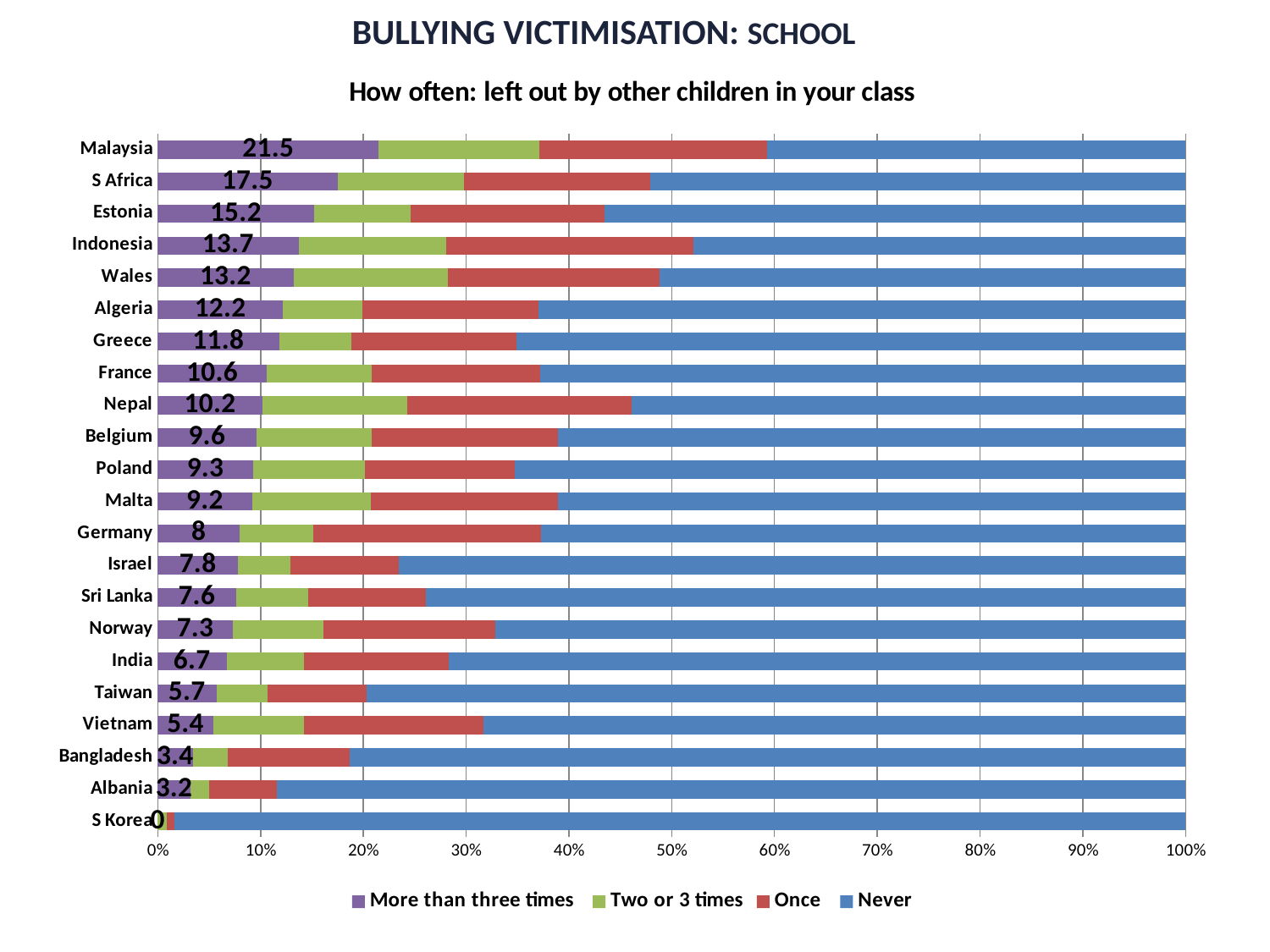
How many countries are shown in the chart? 22 What is the 'More than three times' value for Germany? 8 What is the subtitle of the chart? How often: left out by other children in your class What type of chart is shown on the slide? stacked bar chart How many series does the legend list? 4 What is the difference between the 'More than three times' values for Malaysia and S Africa? 4 Which country has the highest 'More than three times' value? Malaysia What is the 'More than three times' value for Vietnam? 5.4 Is the 'Never' value for Israel greater or less than 70%? greater What is the 'More than three times' value for Malaysia? 21.5 Which has a larger 'More than three times' value, Estonia or Wales? Estonia Which country has the lowest 'More than three times' value? S Korea